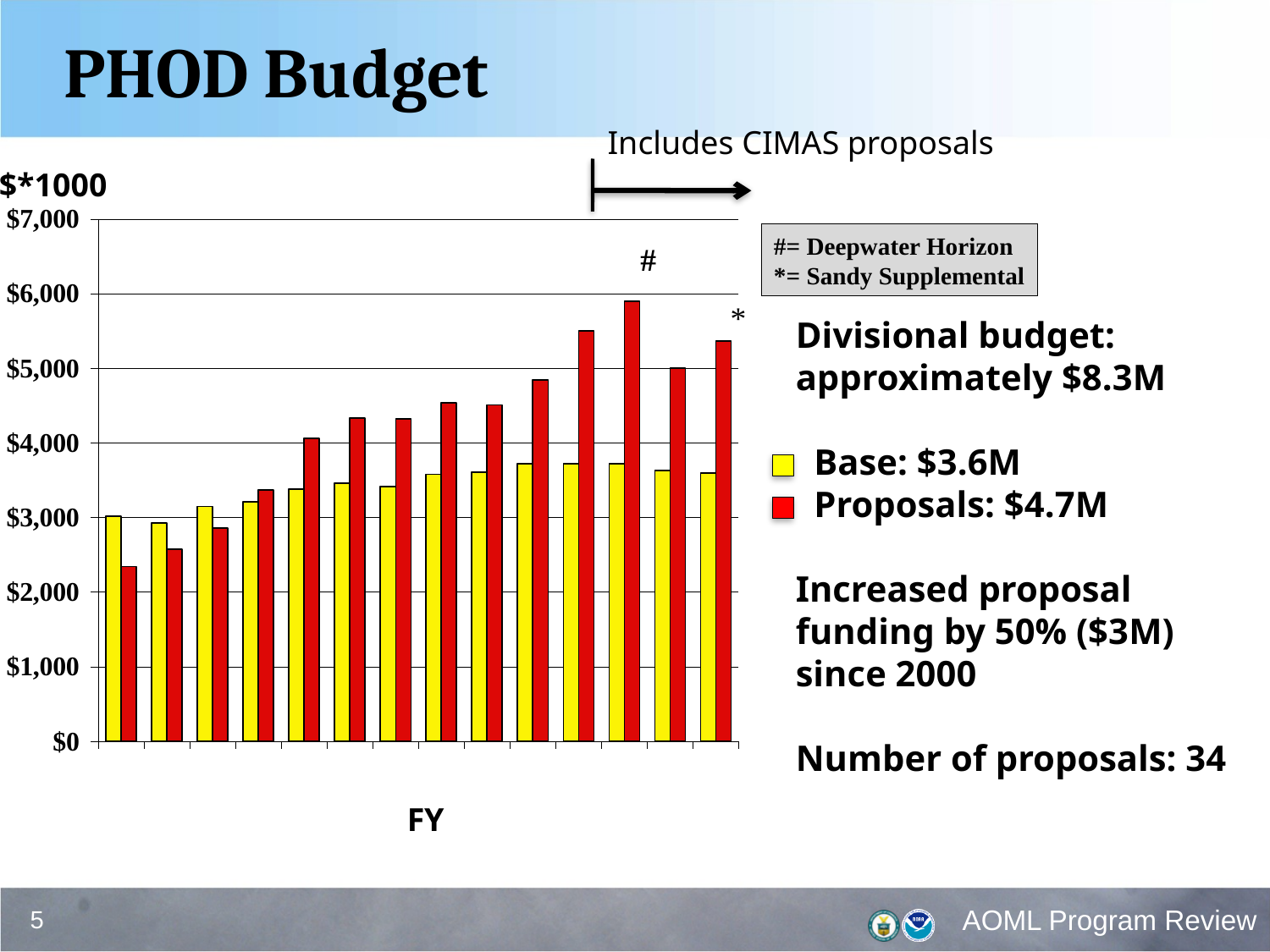
Is the value of the rightmost yellow (Base) bar greater or less than $4,000? less Is the value of the red (Proposals) bar marked with # greater or less than $5,000? greater Do the red (Proposals) bars generally rise or fall from left to right along the x axis? Rise How many series does the chart's legend list? 2 What kind of chart is shown on the slide? Bar chart Which series is shown in red in the chart? Proposals How many pairs of bars (fiscal years) are plotted in the chart? 14 What is the label on the x axis of the chart? FY In the leftmost pair of bars, which is larger, the yellow (Base) bar or the red (Proposals) bar? Yellow (Base) Is the value of the leftmost red (Proposals) bar greater or less than $3,000? less In the rightmost pair of bars, which is larger, the yellow (Base) bar or the red (Proposals) bar? Red (Proposals) Which series contains the tallest bar in the chart? Proposals